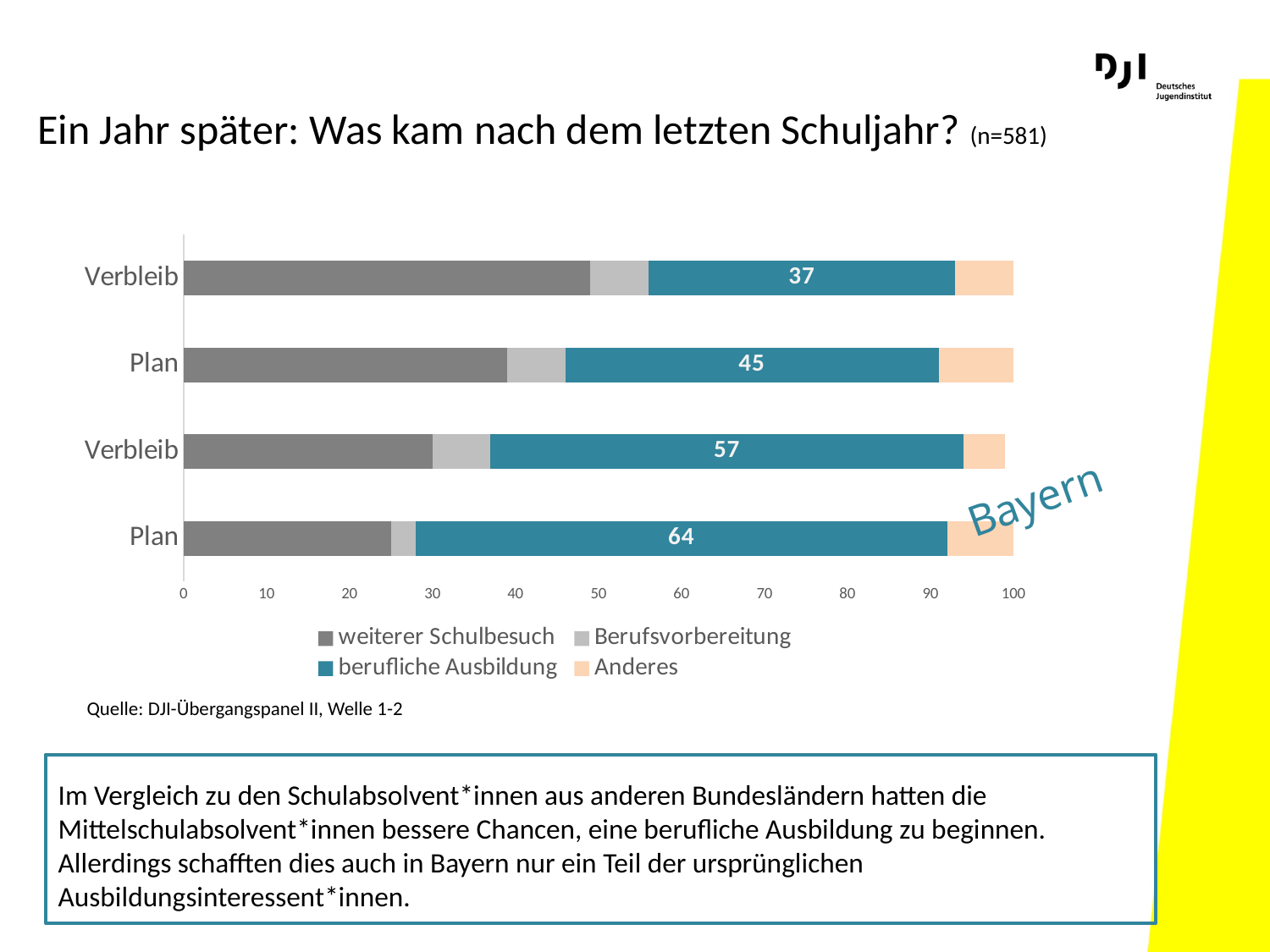
Is the 'weiterer Schulbesuch' segment of the bottom bar (Plan, Bayern) greater or less than 30? less How many series does the legend list? 4 What kind of chart is shown on the slide? Stacked bar chart What is the value of the 'berufliche Ausbildung' segment in the top bar (Verbleib)? 37 How many bars are shown in the chart? 4 Which is larger: the 'berufliche Ausbildung' value in the second bar from the top or in the third bar from the top? The third bar from the top (57) What is the difference between the 'berufliche Ausbildung' values of the bottom bar (64) and the third bar from the top (57)? 7 Which bar has the highest labelled 'berufliche Ausbildung' value? The bottom bar (Plan, Bayern) What is the value of the 'berufliche Ausbildung' segment in the bottom bar (Plan, Bayern)? 64 What is the value of the 'berufliche Ausbildung' segment in the second bar from the top (Plan)? 45 Which bar has the lowest labelled 'berufliche Ausbildung' value? The top bar (Verbleib) What is the difference between the 'berufliche Ausbildung' values of the second bar (45) and the top bar (37)? 8